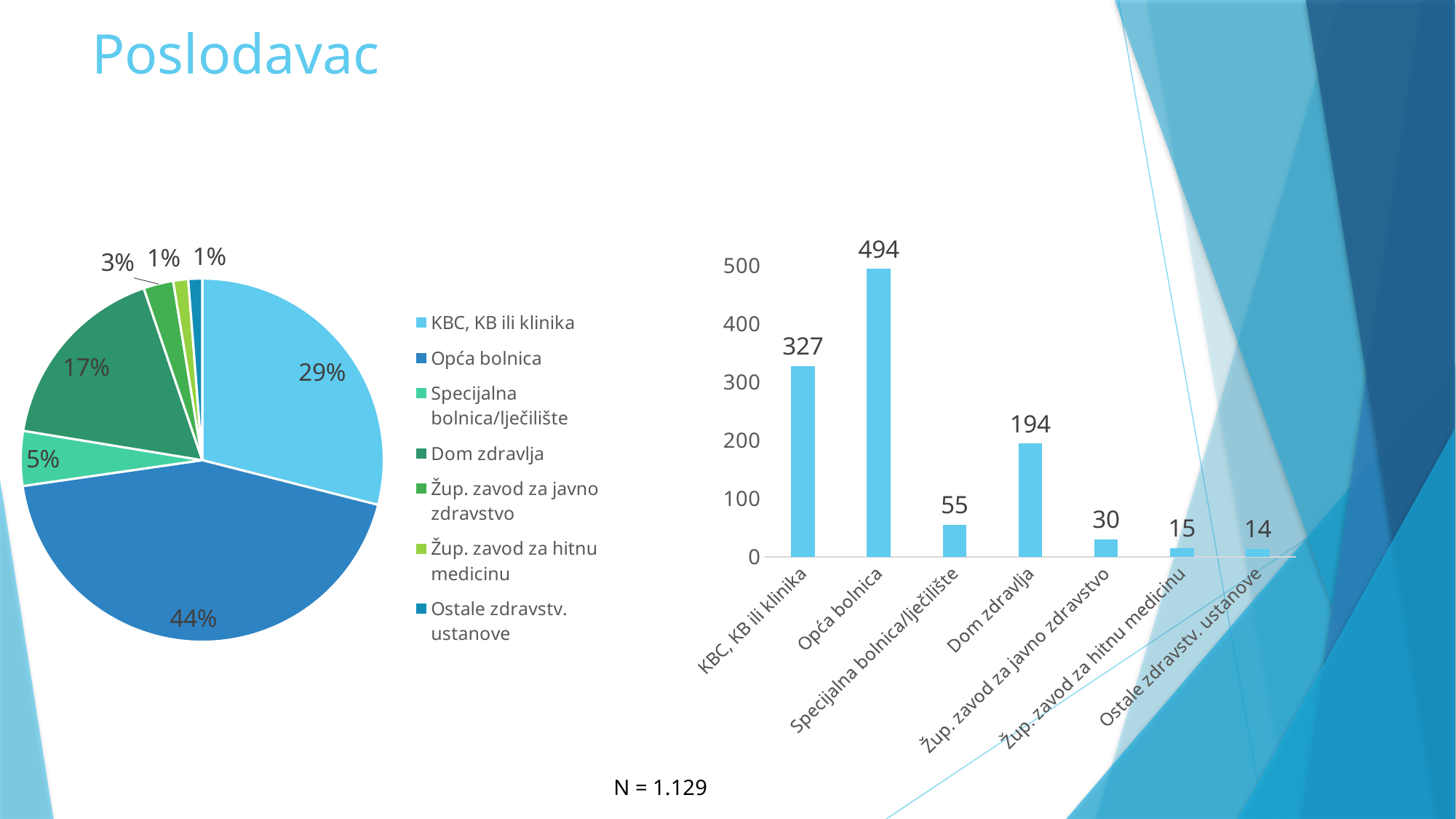
In the bar chart on the right, which is larger: the value for Specijalna bolnica/lječilište or the value for Žup. zavod za javno zdravstvo? Specijalna bolnica/lječilište How many entries does the legend of the pie chart on the left list? 7 In the bar chart on the right, what is the value for Opća bolnica? 494 In the pie chart on the left, which category has the largest slice? Opća bolnica In the bar chart on the right, what is the difference between the values for Opća bolnica and KBC, KB ili klinika? 167 In the bar chart on the right, how many categories are shown on the x axis? 7 In the bar chart on the right, which category has the highest value? Opća bolnica In the bar chart on the right, what is the value for Dom zdravlja? 194 What kind of chart is shown on the right side of the slide? Bar chart In the pie chart on the left, what share does Dom zdravlja have? 17% In the pie chart on the left, what share does Opća bolnica have? 44% In the bar chart on the right, which category has the lowest value? Ostale zdravstv. ustanove